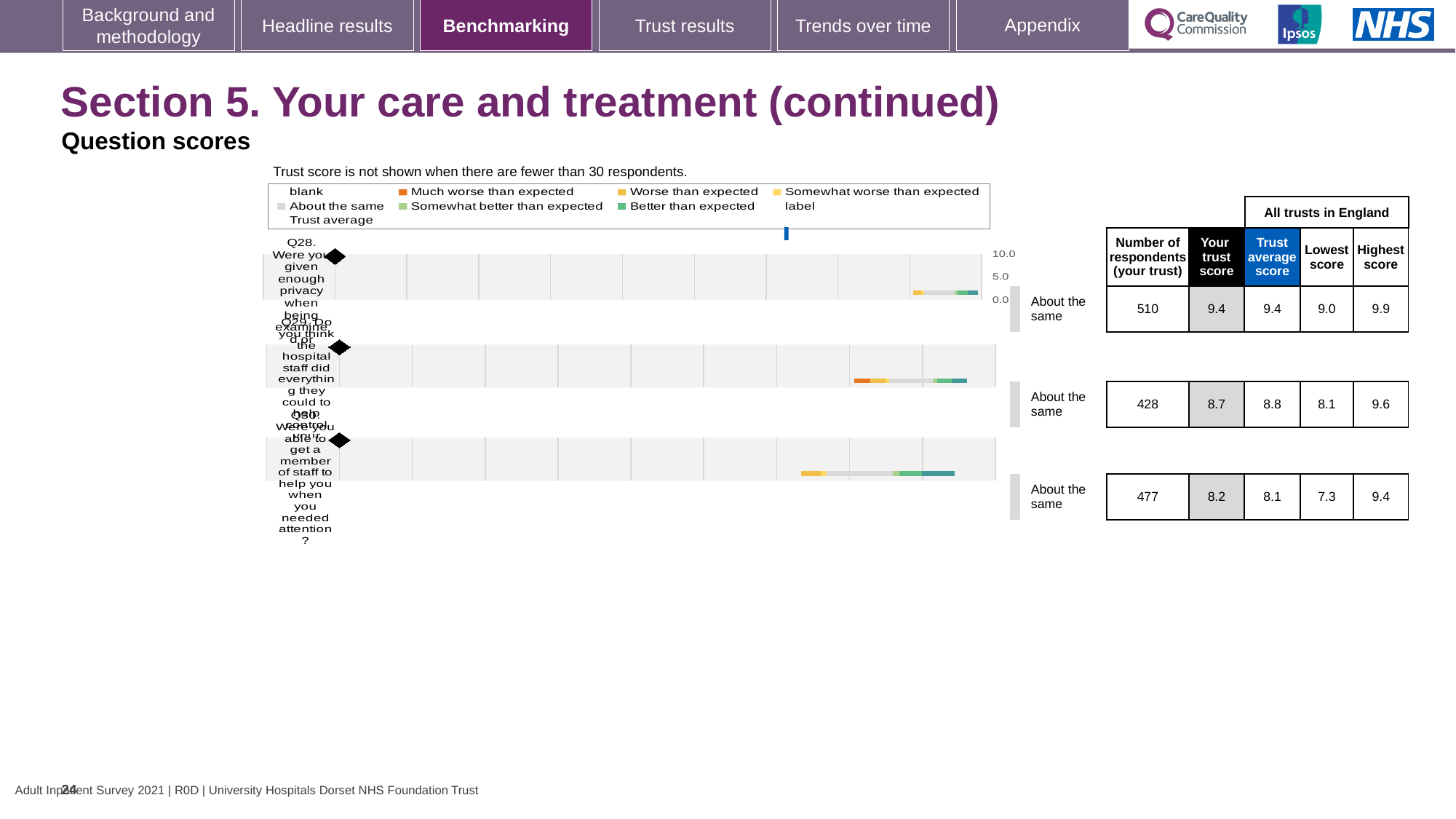
How many respondents answered Q29 at this trust? 428 What is the difference between the trust score for Q28 and the trust score for Q30? 1.2 What kind of chart is used to show the question scores? Bar chart What is the difference between the highest score and the lowest score for Q29? 1.5 For Q29, which is larger: the trust score or the trust average score? Trust average score Is the trust score for Q30 greater or less than 5.0? greater Which question has the lowest trust score on this slide? Q30 What is the highest score across all trusts in England for Q30? 9.4 What benchmark category is shown for Q30? About the same How many questions are plotted in the chart? 3 What is the trust score for Q28 (privacy when being examined or treated)? 9.4 Which question has the highest trust score on this slide? Q28